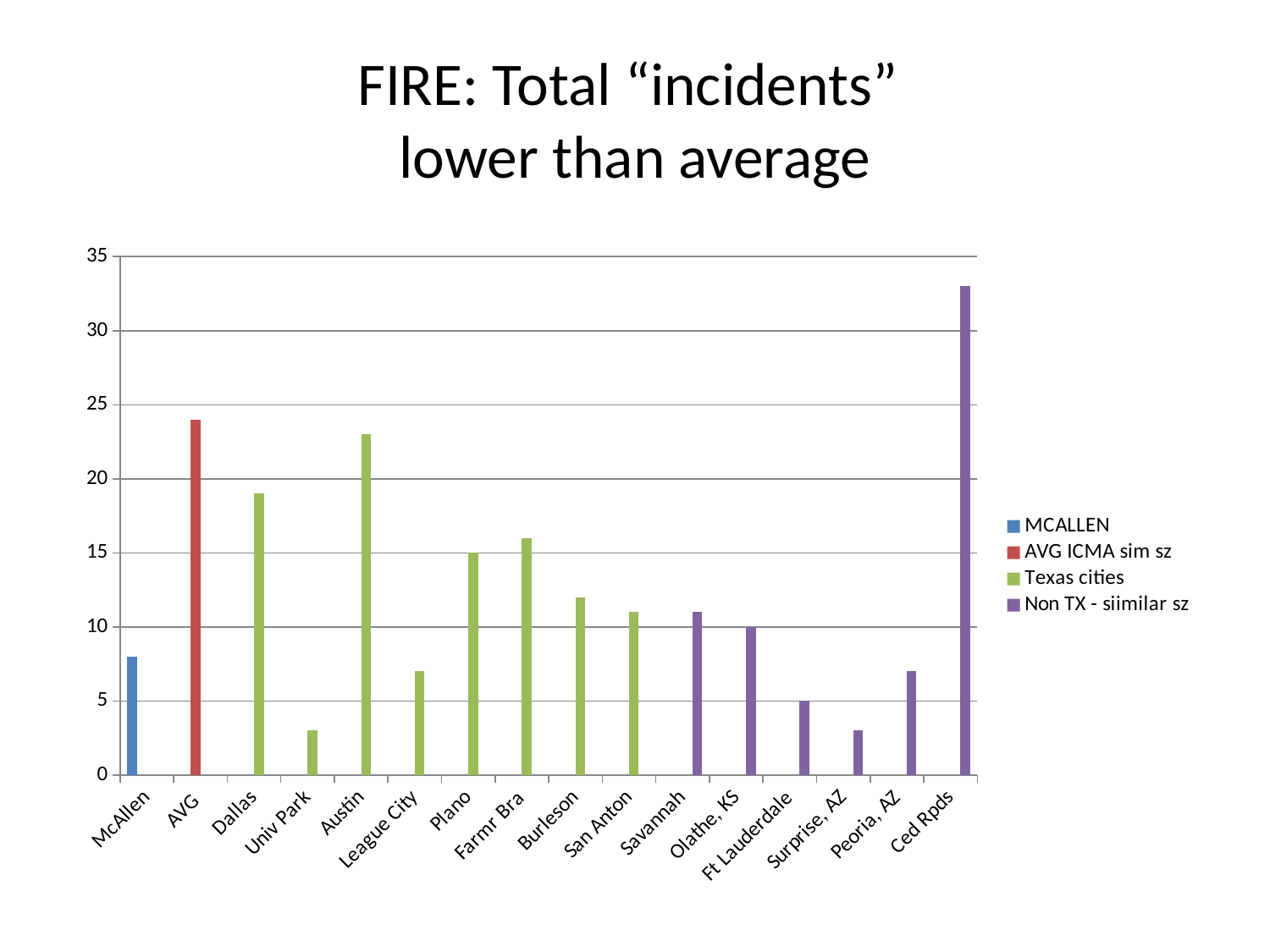
How many cities/categories are shown on the x axis? 16 What is the value for Olathe, KS? 10 Which category has the highest value? Ced Rpds Which is larger, the value for Dallas or the value for Austin? Austin How many series does the legend list? 4 Is the value for Ced Rpds greater or less than 30? greater What is the value for Plano? 15 What kind of chart is shown on the slide? bar chart Is the value for McAllen greater or less than 10? less What is the value for Ft Lauderdale? 5 Is the value for AVG greater or less than 20? greater Which legend entry is shown in purple? Non TX - siimilar sz